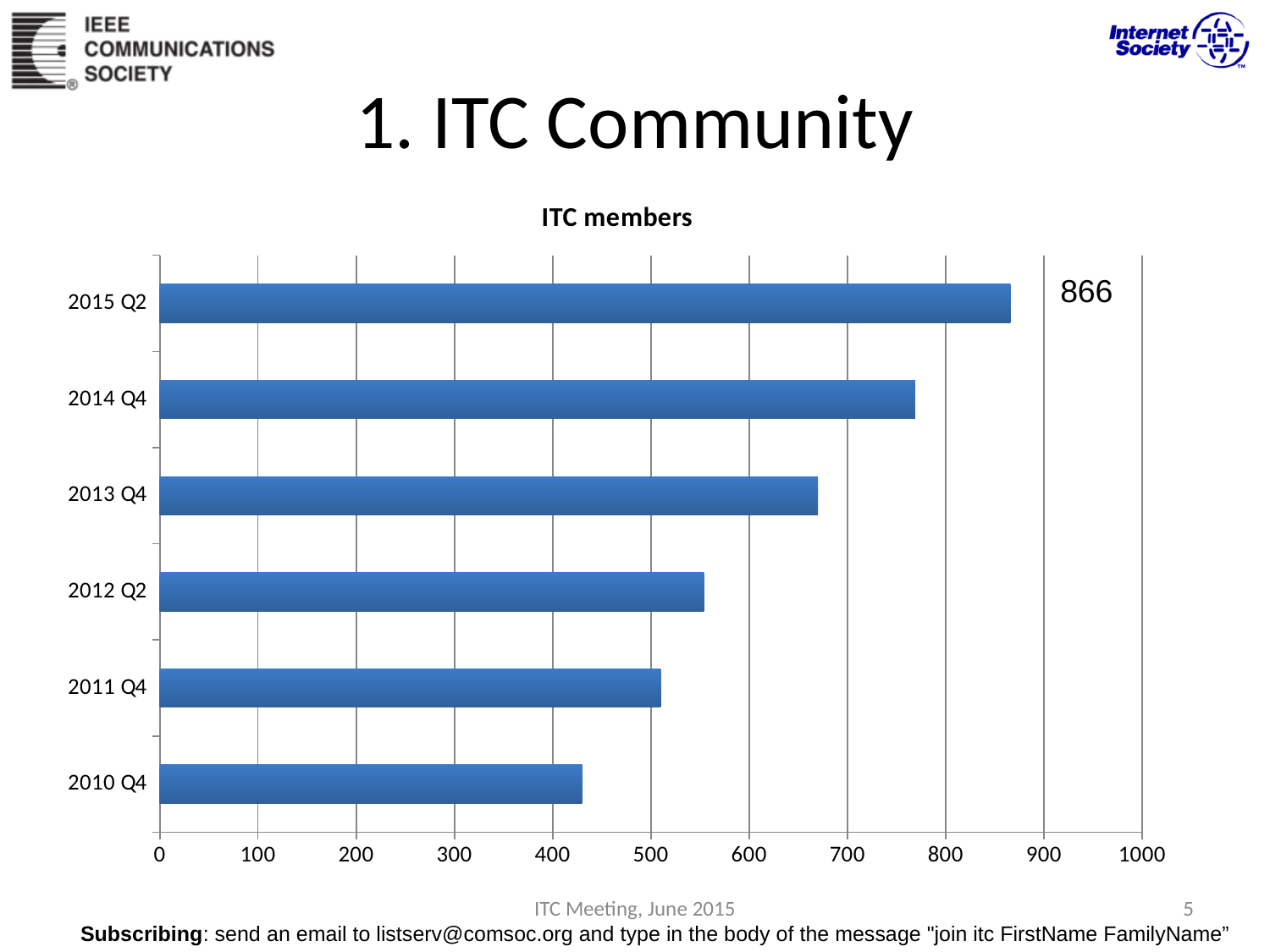
Is the value for 2011 Q4 greater or less than 600? less Is the value for 2010 Q4 greater or less than 500? less Do ITC member numbers rise or fall from 2010 Q4 to 2015 Q2? rise Which has fewer ITC members, 2010 Q4 or 2012 Q2? 2010 Q4 How many periods are shown in the ITC members chart? 6 Which period has the highest number of ITC members? 2015 Q2 Which period has the lowest number of ITC members? 2010 Q4 What kind of chart is used to show ITC members? bar chart Is the value for 2013 Q4 greater or less than 700? less What is the value shown for 2015 Q2 in the ITC members chart? 866 Which has more ITC members, 2013 Q4 or 2014 Q4? 2014 Q4